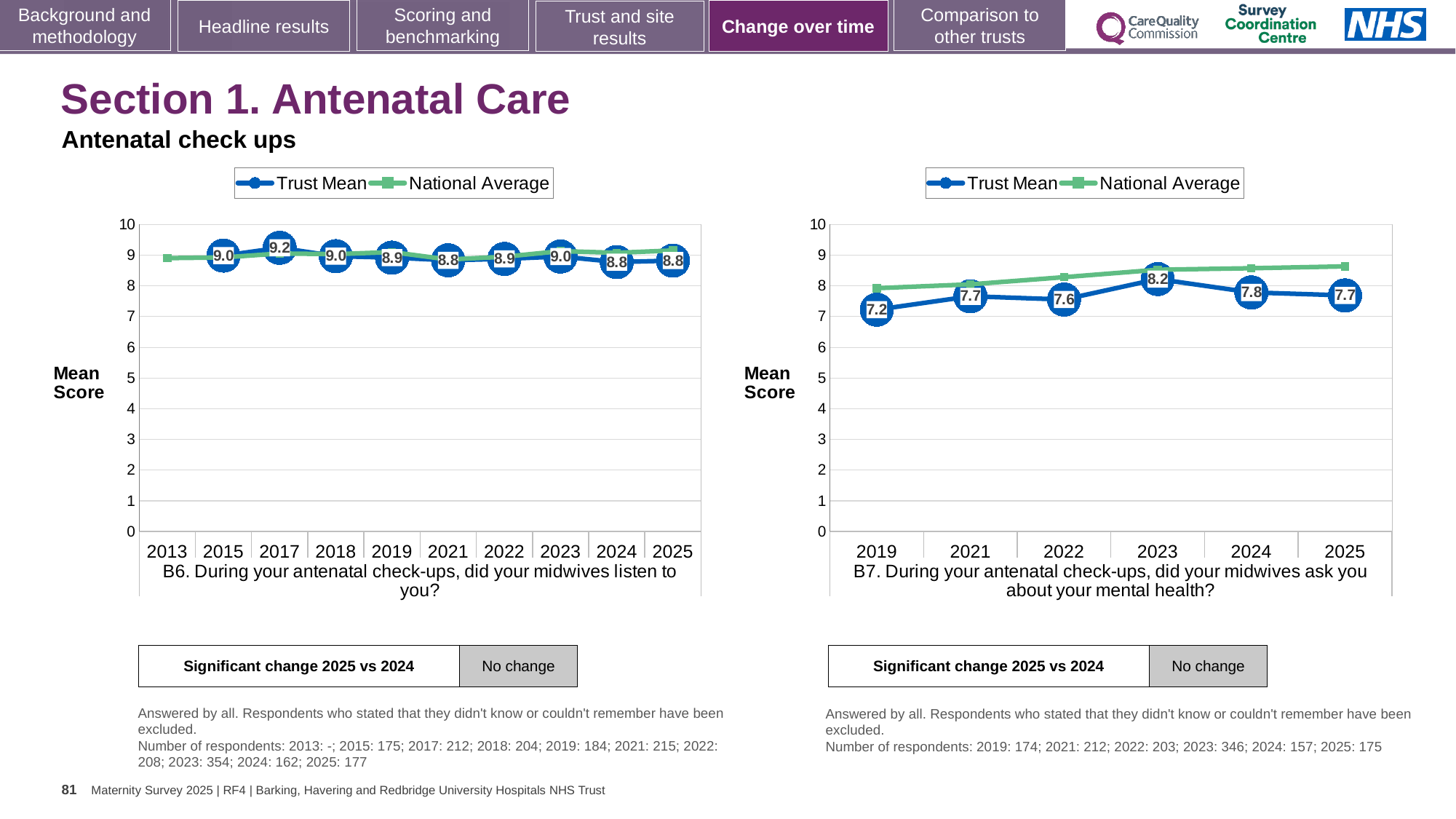
In the right chart (B7), what is the Trust Mean for 2023? 8.2 In the left chart (B6), what is the difference between the Trust Mean in 2017 and in 2025? 0.4 In the left chart (B6), what is the Trust Mean for 2025? 8.8 What kind of chart is the left chart (B6)? Line chart How many series does the legend of the right chart (B7) list? 2 In the right chart (B7), which year has the highest Trust Mean? 2023 In the left chart (B6), how many years are shown on the x axis? 10 In the right chart (B7), what is the difference between the Trust Mean in 2023 and in 2019? 1.0 In the left chart (B6), what is the Trust Mean for 2017? 9.2 In the left chart (B6), which year has the highest Trust Mean? 2017 In the right chart (B7), which year has the lowest Trust Mean? 2019 In the right chart (B7), is the National Average for 2025 greater or less than 8? greater